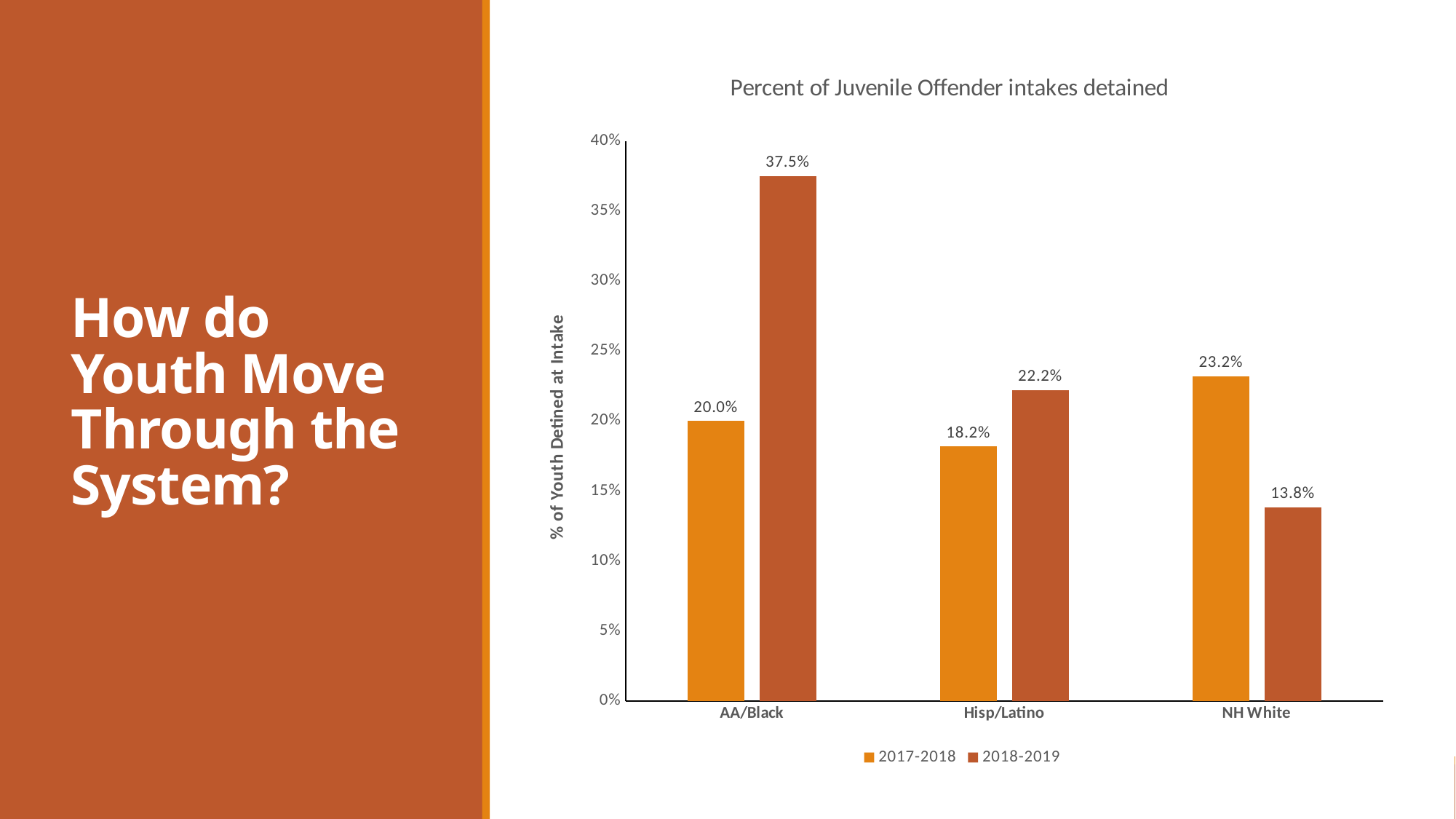
How many categories are shown on the x axis? 3 Which category has the highest 2018-2019 value? AA/Black Is the 2018-2019 value for NH White greater or less than 15%? less What is the difference between the 2018-2019 and 2017-2018 values for AA/Black? 17.5% What kind of chart is shown? bar chart Which category has the lowest 2017-2018 value? Hisp/Latino Which is larger for NH White, the 2017-2018 value or the 2018-2019 value? 2017-2018 How many series does the legend list? 2 What is the 2018-2019 value for Hisp/Latino? 22.2% What is the title of the chart? Percent of Juvenile Offender intakes detained What is the 2018-2019 value for AA/Black? 37.5% What is the 2017-2018 value for NH White? 23.2%